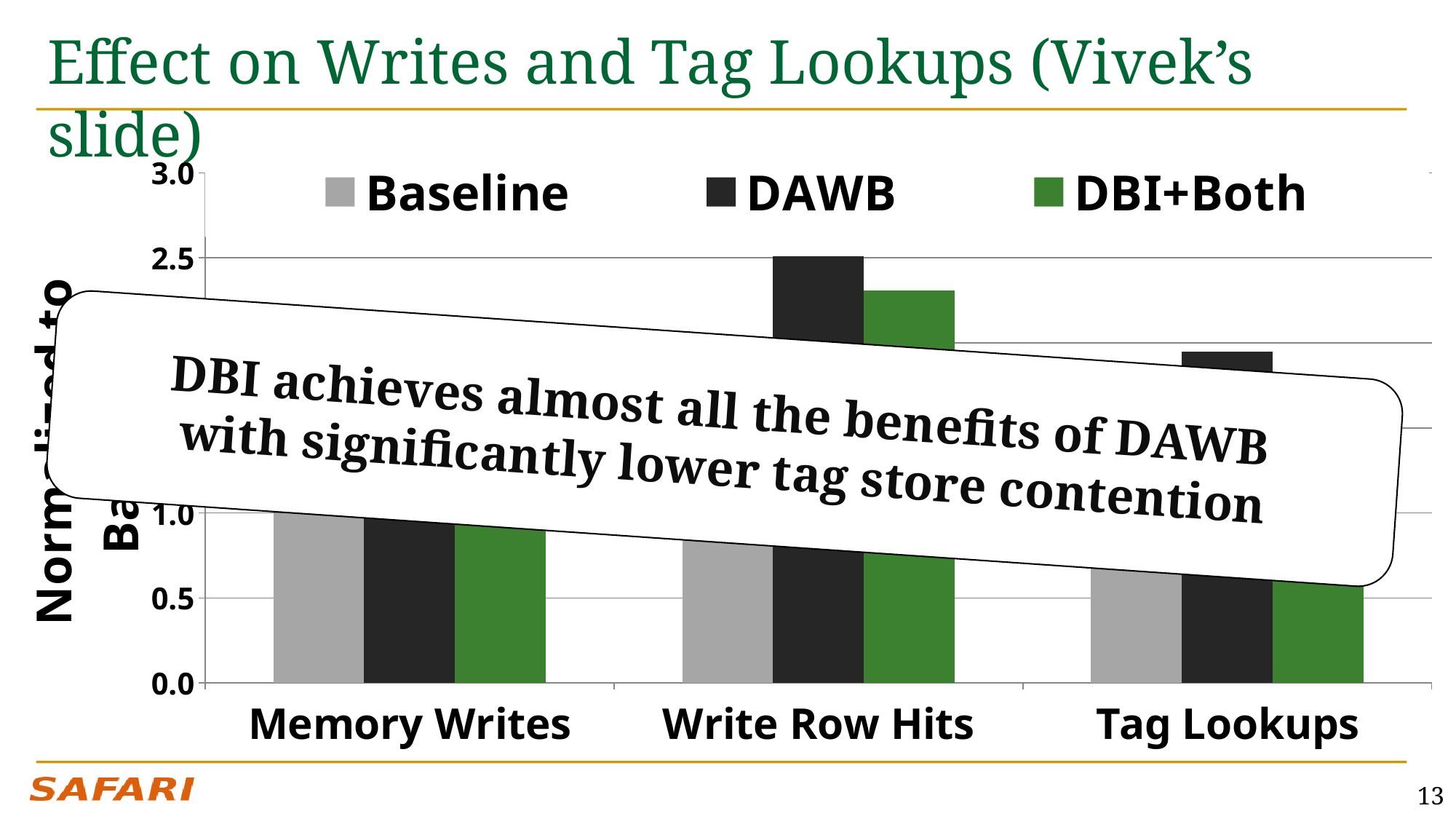
What are the three series named in the chart's legend? Baseline, DAWB, DBI+Both Is the DBI+Both value for Write Row Hits greater or less than 2.0? greater How many series does the chart's legend list? 3 Which category has the highest DAWB bar? Write Row Hits Is the DAWB value for Tag Lookups greater or less than 1.5? greater What kind of chart is shown on the slide? bar chart Which is larger: the Baseline bar for Memory Writes or the DAWB bar for Write Row Hits? DAWB bar for Write Row Hits What is the highest value labelled on the chart's y axis? 3.0 Is the DAWB value for Write Row Hits greater or less than 2.0? greater For Write Row Hits, which is larger: the DAWB bar or the DBI+Both bar? DAWB How many categories are shown on the x axis of the chart? 3